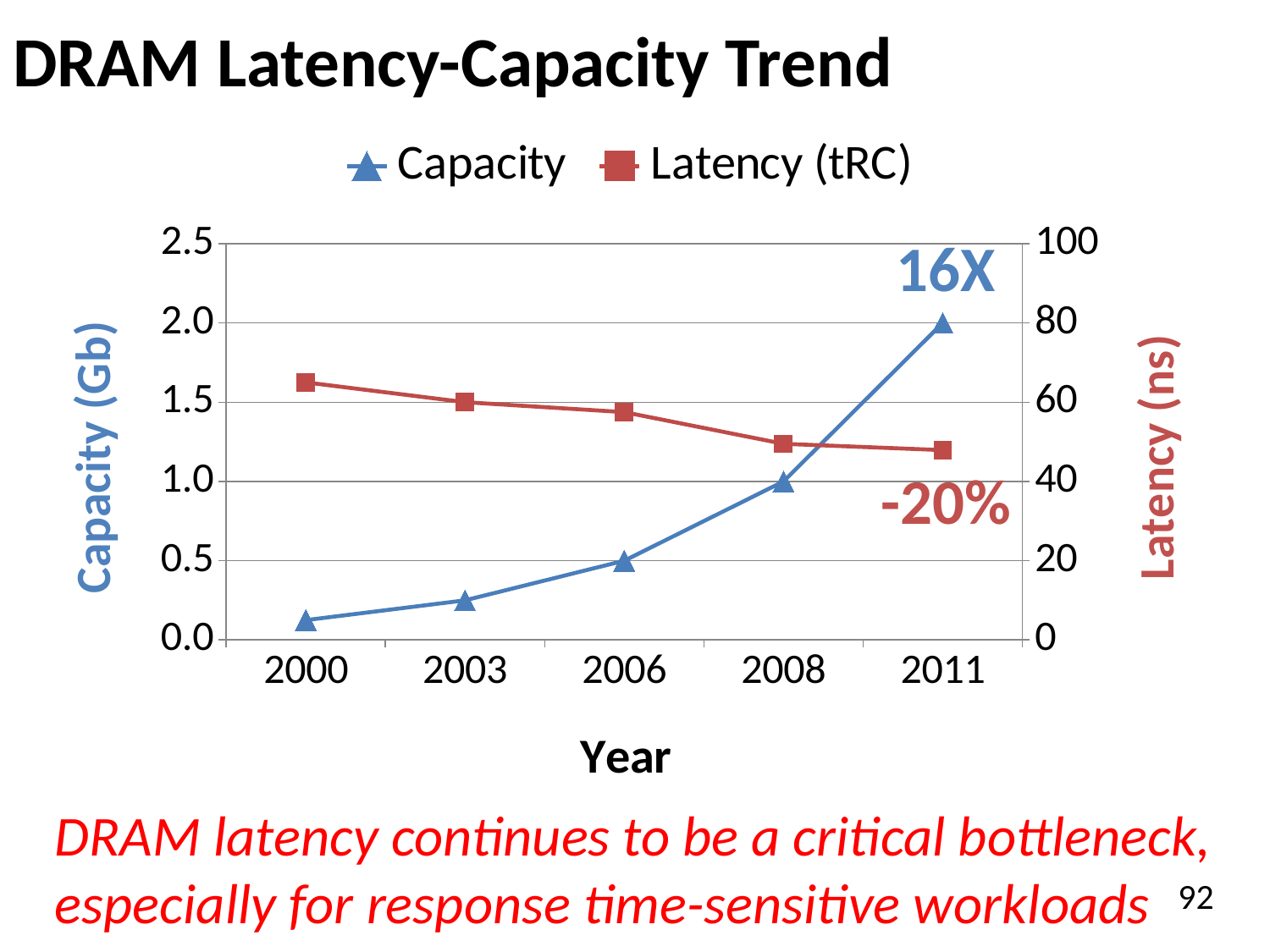
In which year is Latency (tRC) highest? 2000 In which year is Capacity highest? 2011 How many years are plotted along the x axis? 5 What is the Capacity value for 2008? 1.0 Is the Latency (tRC) value for 2011 greater or less than 60? less Does the Latency (tRC) series rise or fall from 2000 to 2011? fall Is the Latency (tRC) value for 2000 greater or less than 60? greater Does the Capacity series rise or fall from 2000 to 2011? rise What is the Capacity value for 2011? 2.0 How many series does the legend list? 2 What annotation is printed next to the end of the Capacity line? 16X What kind of chart is shown on the slide? line chart